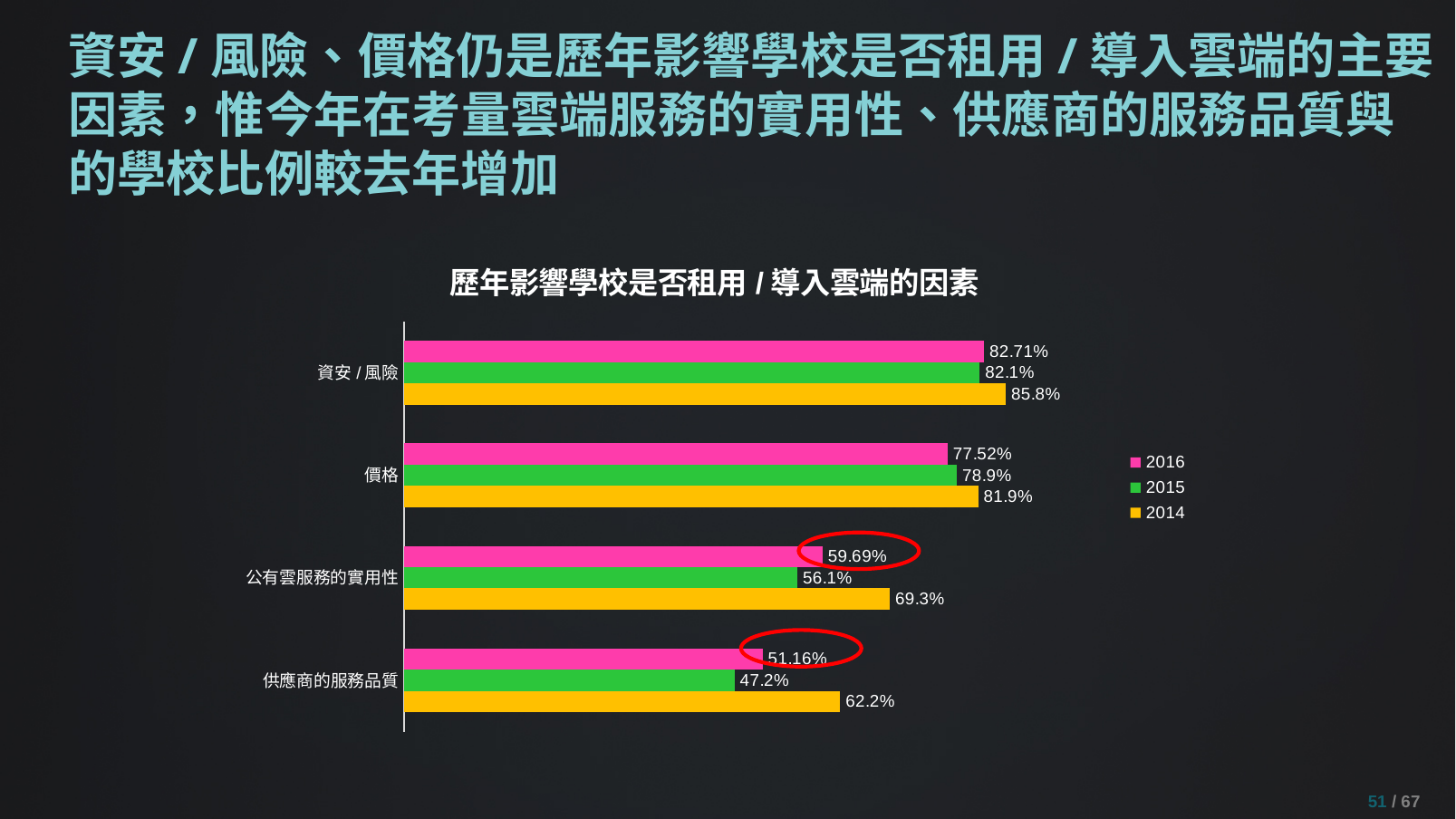
What is the difference between the 2014 and 2015 values for 公有雲服務的實用性? 13.2% What is the 2014 value for 供應商的服務品質? 62.2% Which category has the lowest 2015 value? 供應商的服務品質 What is the 2016 value for 資安 / 風險? 82.71% What is the 2014 value for 價格? 81.9% Which is larger for 價格: the 2016 value or the 2015 value? 2015 What is the title of the chart? 歷年影響學校是否租用 / 導入雲端的因素 How many categories are shown on the chart? 4 How many series does the legend list? 3 What is the 2015 value for 公有雲服務的實用性? 56.1% Which category has the highest 2016 value? 資安 / 風險 What kind of chart is shown on the slide? bar chart